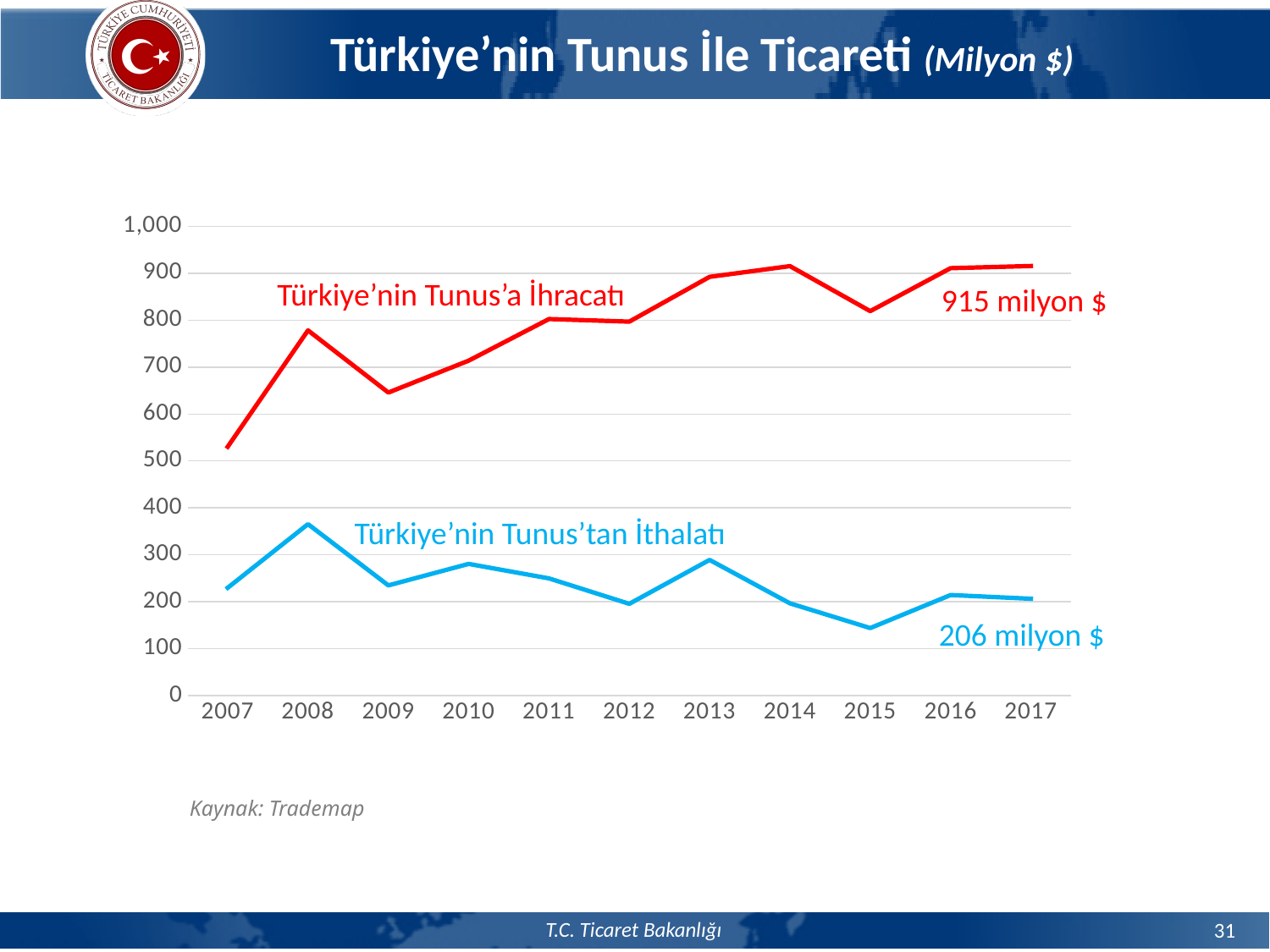
In which year is Türkiye'nin Tunus'tan İthalatı highest? 2008 How many series are plotted on the chart? 2 Is the value for Türkiye'nin Tunus'tan İthalatı in 2008 greater or less than 300? greater What kind of chart is shown on the slide? Line chart Which is larger for Türkiye'nin Tunus'a İhracatı: 2008 or 2009? 2008 What is the difference between Türkiye'nin Tunus'a İhracatı and Türkiye'nin Tunus'tan İthalatı in 2017? 709 milyon $ Does Türkiye'nin Tunus'tan İthalatı rise or fall from 2013 to 2015? Fall In which year is Türkiye'nin Tunus'a İhracatı lowest? 2007 Is the value for Türkiye'nin Tunus'a İhracatı in 2007 greater or less than 600? less How many years are shown on the x axis? 11 What is the value of Türkiye'nin Tunus'tan İthalatı in 2017? 206 milyon $ What is the value of Türkiye'nin Tunus'a İhracatı in 2017? 915 milyon $